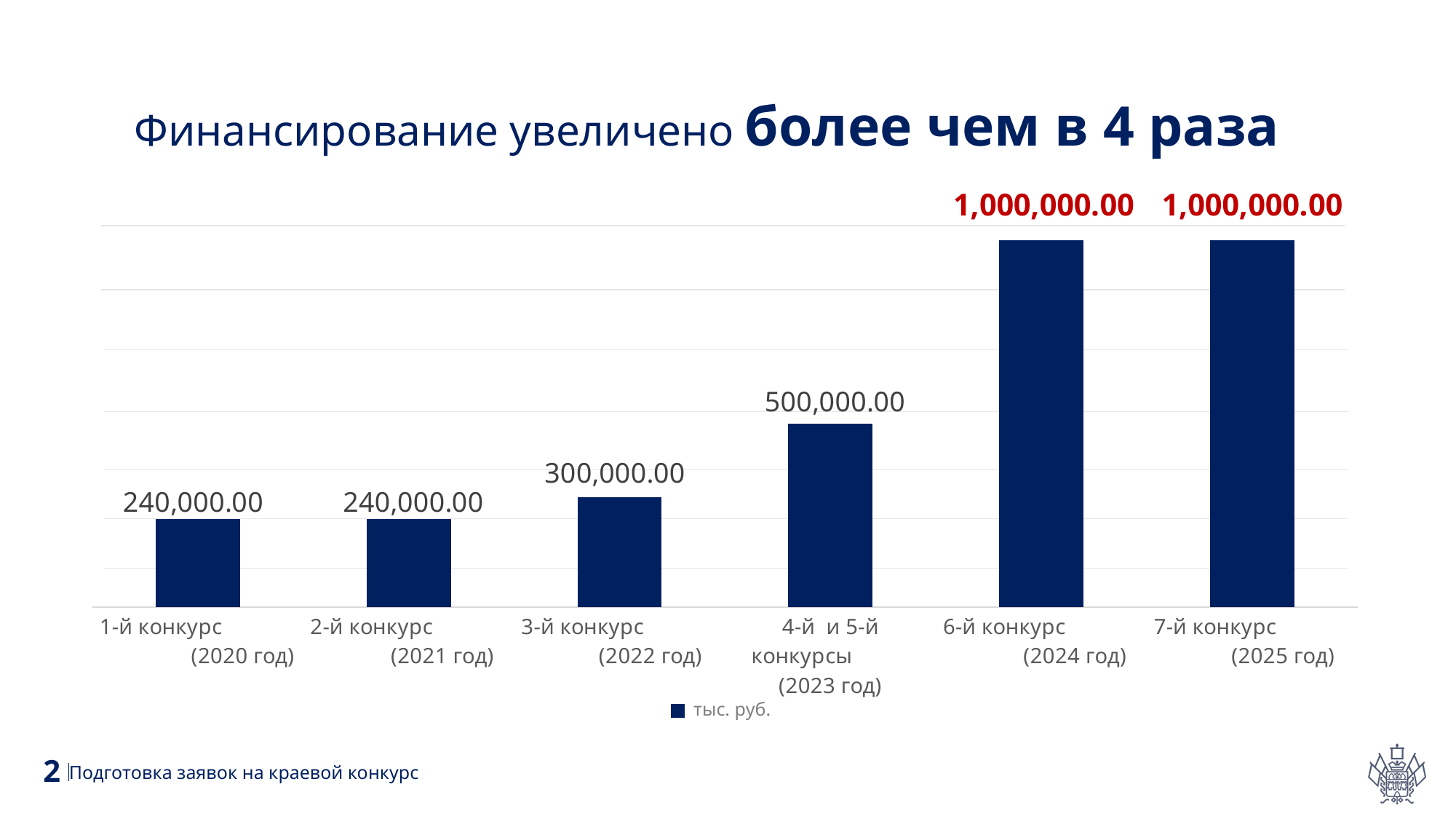
What is the value for 1-й конкурс (2020 год)? 240,000.00 What is the value for 4-й и 5-й конкурсы (2023 год)? 500,000.00 Which has a larger value: 3-й конкурс (2022 год) or 2-й конкурс (2021 год)? 3-й конкурс (2022 год) What is the value for 7-й конкурс (2025 год)? 1,000,000.00 What kind of chart is shown on the slide? Bar chart What is the value for 3-й конкурс (2022 год)? 300,000.00 How many series does the legend list? 1 What is the lowest value shown in the chart? 240,000.00 How many categories are shown on the x axis of the chart? 6 What is the difference between the value for 4-й и 5-й конкурсы (2023 год) and the value for 3-й конкурс (2022 год)? 200,000.00 Do the values rise or fall from 1-й конкурс (2020 год) to 6-й конкурс (2024 год)? Rise What is the highest value shown in the chart? 1,000,000.00